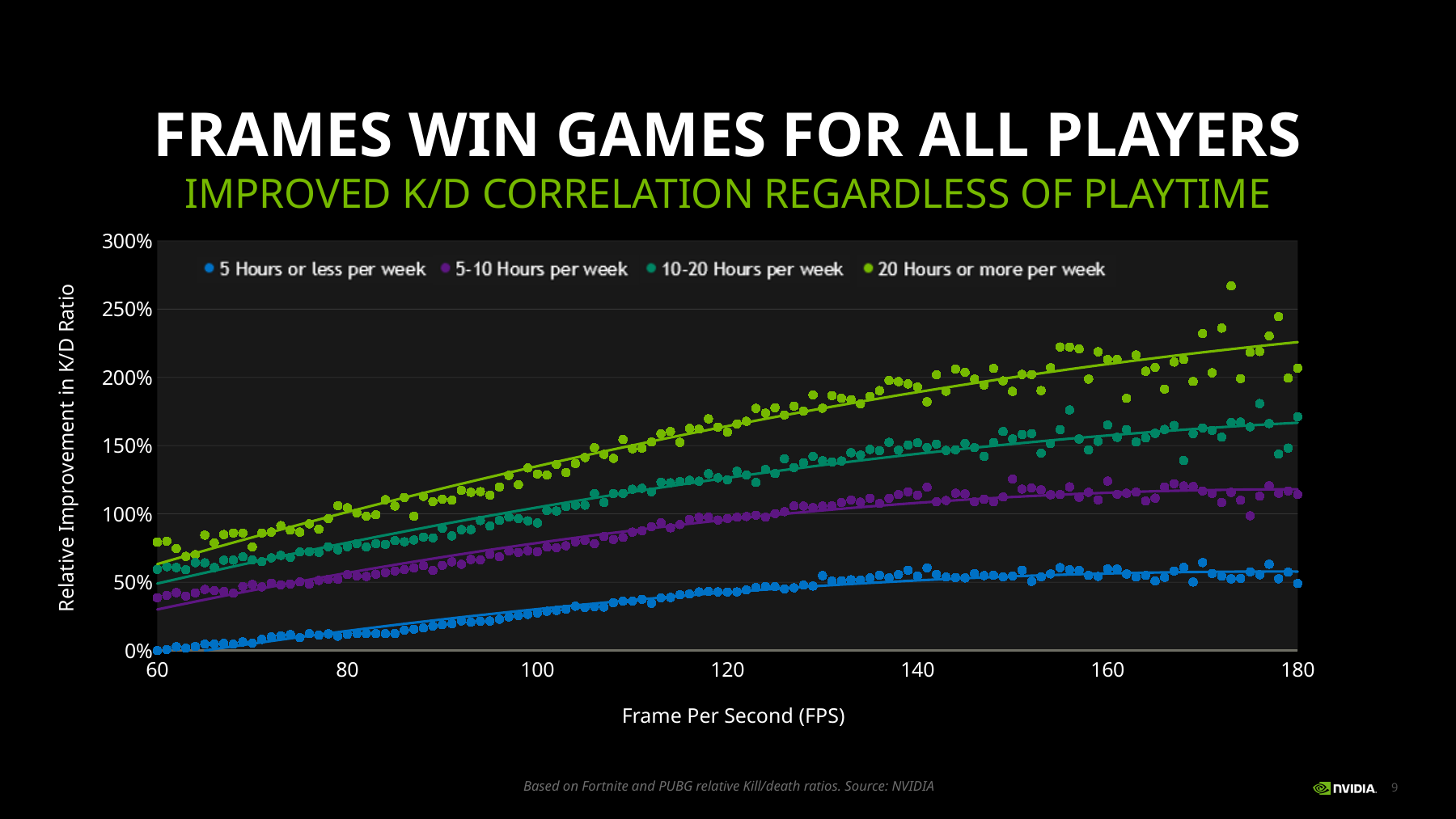
How many series does the legend list? 4 What is the title of the x axis? Frame Per Second (FPS) What is the title of the y axis? Relative Improvement in K/D Ratio Is the value for 10-20 Hours per week at 60 FPS greater or less than 100%? less What kind of chart is shown on the slide? Scatter chart Is the value for 20 Hours or more per week at 180 FPS greater or less than 150%? greater Which series shows the lowest relative improvement in K/D ratio across the FPS range? 5 Hours or less per week Is the value for 5 Hours or less per week at 180 FPS greater or less than 100%? less At 120 FPS, which series has the larger value: 20 Hours or more per week or 5 Hours or less per week? 20 Hours or more per week Which series shows the highest relative improvement in K/D ratio across the FPS range? 20 Hours or more per week Do the values for the 5 Hours or less per week series rise or fall as FPS increases from 60 to 180? Rise